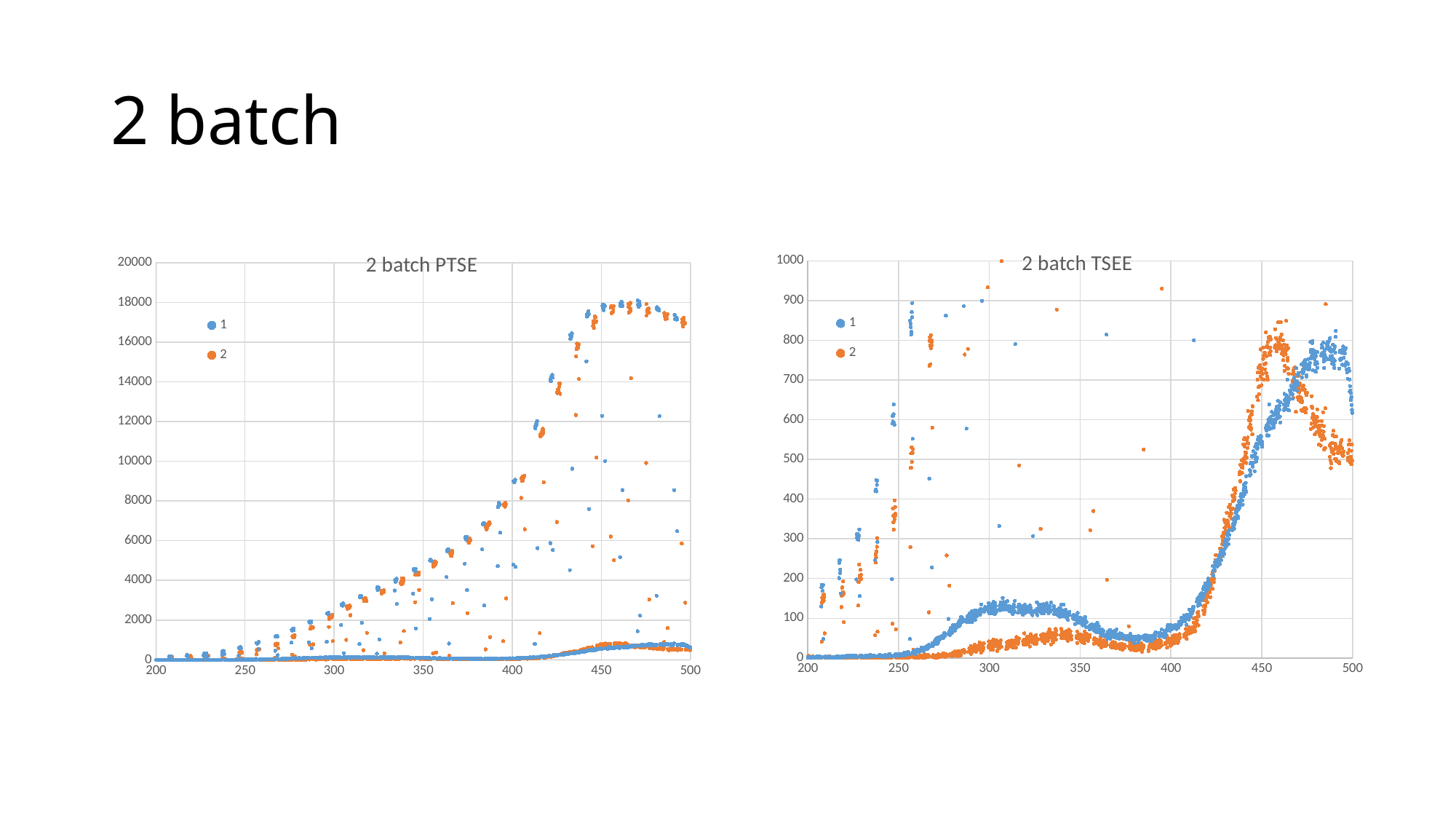
In the "2 batch TSEE" chart, is the highest plotted value of series 1 greater or less than 700? greater In the "2 batch TSEE" chart, do the series 2 values rise or fall as x goes from 460 to 500? fall How many series does the legend of the "2 batch PTSE" chart list? 2 In the "2 batch TSEE" chart, is the highest plotted value of series 2 greater or less than 800? greater In the "2 batch TSEE" chart, what are the names of the series in the legend? 1 and 2 In the "2 batch PTSE" chart, is the highest plotted value greater or less than 16000? greater In the "2 batch PTSE" chart, do the values of the upper band of points rise or fall as x goes from 300 to 450? rise What kind of chart is the "2 batch PTSE" chart? scatter chart What kind of chart is the "2 batch TSEE" chart? scatter chart In the "2 batch PTSE" chart, which colour is used for series 2? orange In the "2 batch TSEE" chart, do the series 1 values rise or fall as x goes from 400 to 450? rise How many series does the legend of the "2 batch TSEE" chart list? 2